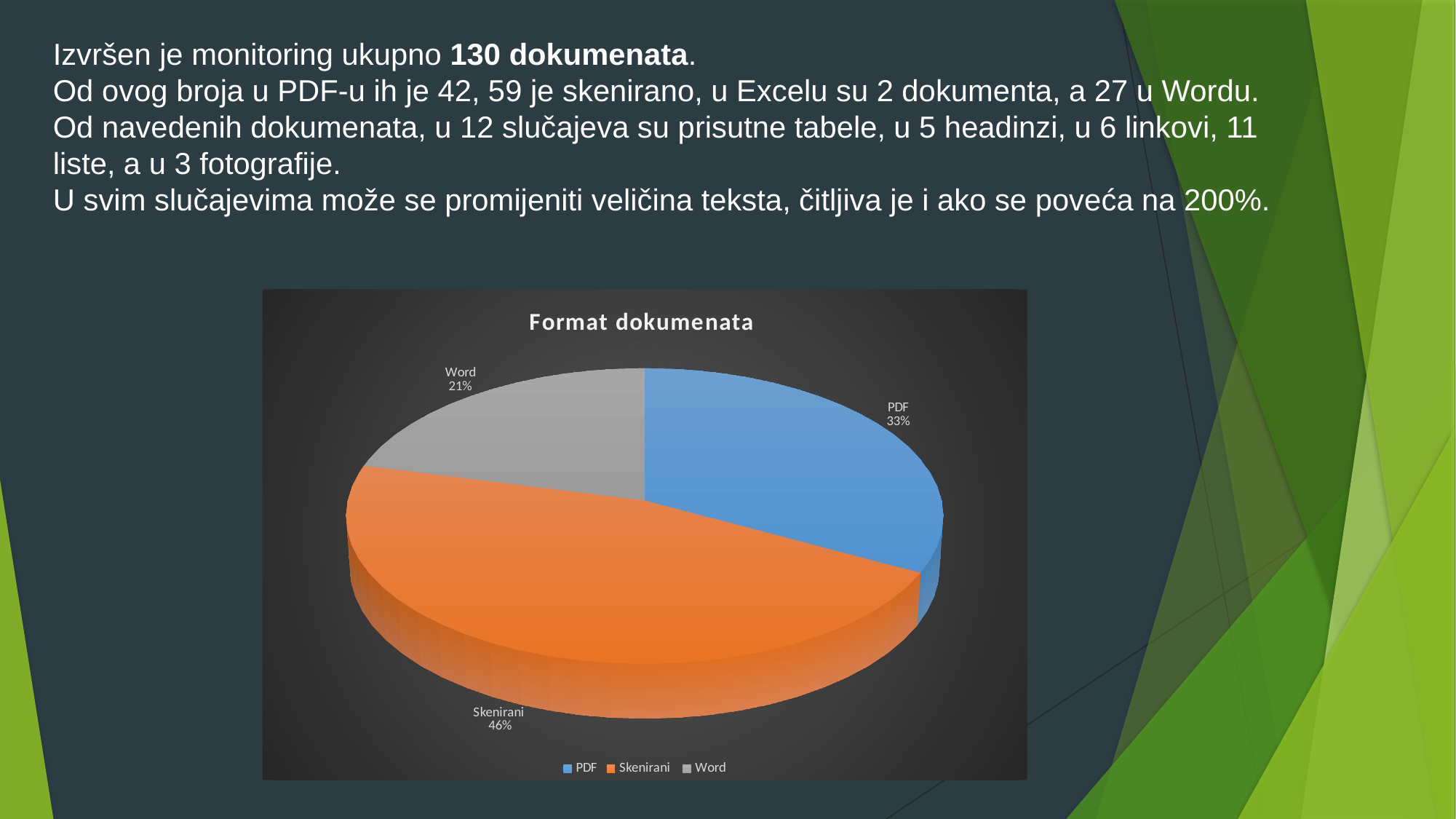
Which category has the smallest slice of the pie? Word What type of chart is shown on the slide? pie chart What colour is the Skenirani slice? orange How many slices does the pie chart have? 3 What share of the pie does the Skenirani slice represent? 46% Which slice is larger, PDF or Word? PDF How many entries does the legend list? 3 Which category has the largest slice of the pie? Skenirani What is the title of the chart? Format dokumenata What share of the pie does the Word slice represent? 21% What share of the pie does the PDF slice represent? 33% What is the difference in percentage points between the Skenirani and PDF slices? 13